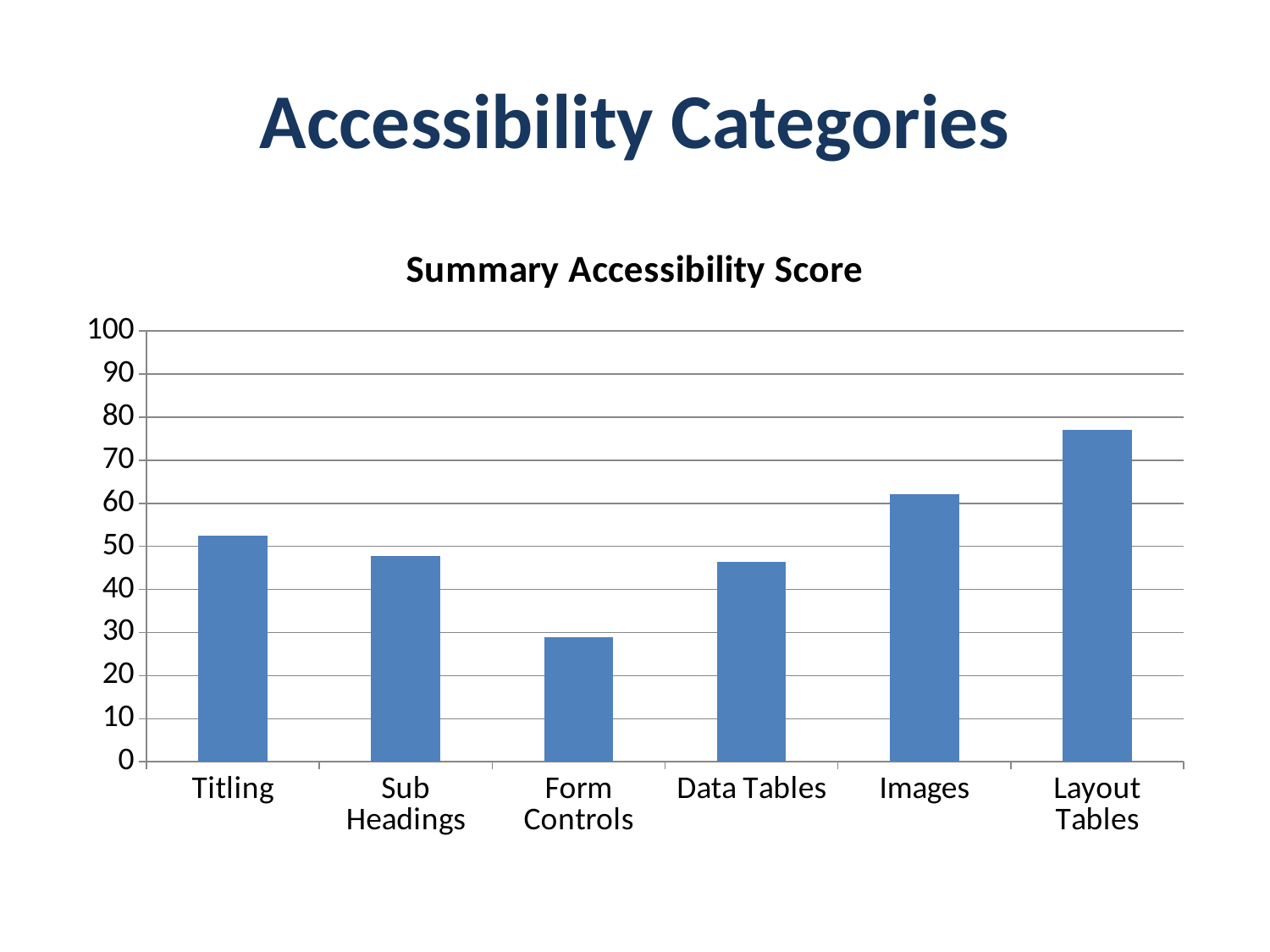
Is the value for Images greater or less than 50? greater What is the title of the chart? Summary Accessibility Score Which category has the lowest Summary Accessibility Score? Form Controls Which category has the highest Summary Accessibility Score? Layout Tables Which has a higher score, Layout Tables or Images? Layout Tables Is the value for Layout Tables greater or less than 70? greater Is the value for Form Controls greater or less than 40? less What type of chart is shown on the slide? bar chart Which has a higher score, Titling or Form Controls? Titling Which has a higher score, Images or Titling? Images How many categories are shown on the x axis of the chart? 6